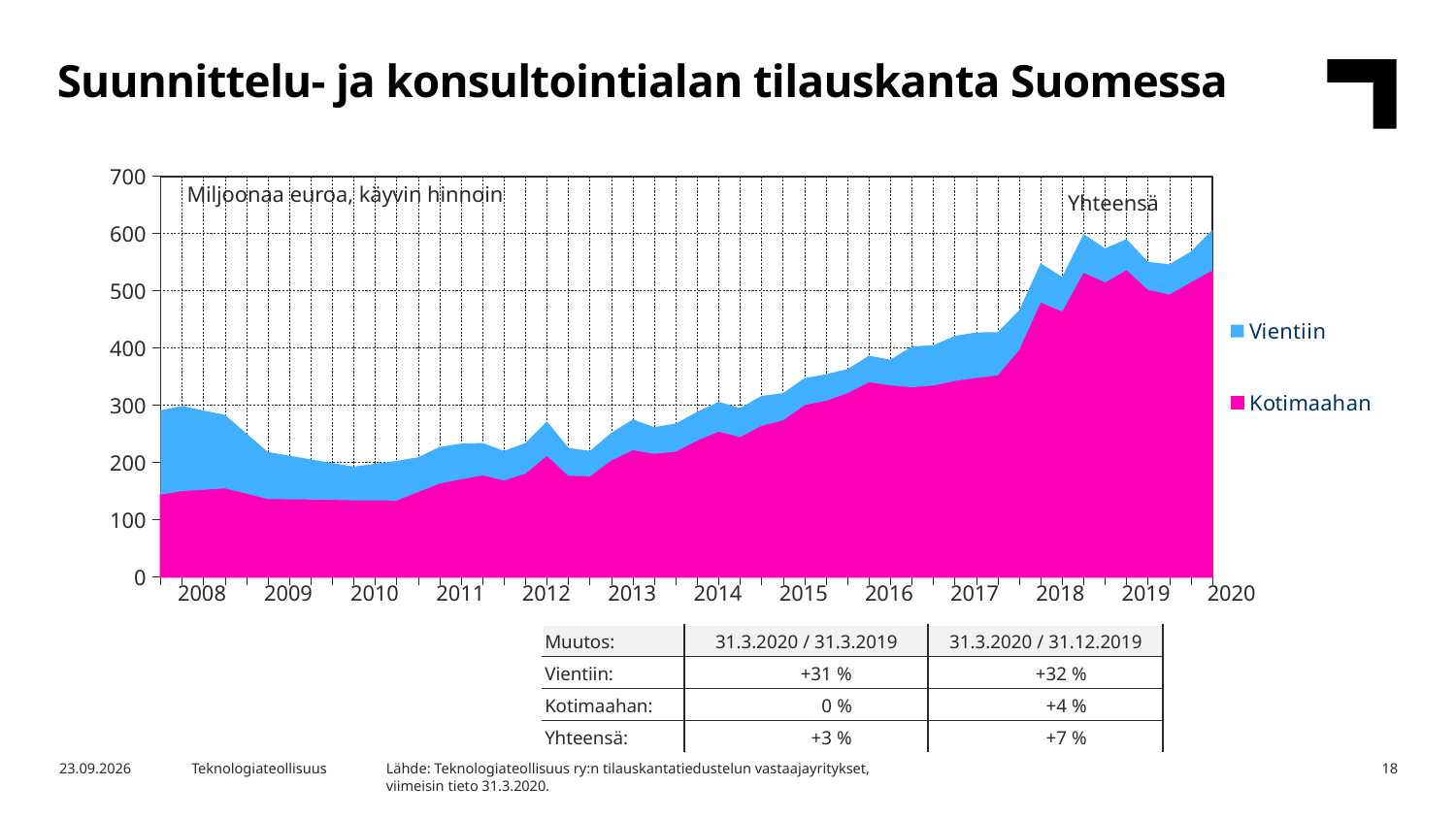
Is the value for Kotimaahan at 2020 greater or less than 500? greater Is the value for Kotimaahan at the start of 2008 greater or less than 200? less What are the two series named in the chart legend? Vientiin and Kotimaahan What unit label is printed inside the chart area at the top left? Miljoonaa euroa, käyvin hinnoin Is the total (Yhteensä) value at 2016 greater or less than 300? greater At 2020, which series has the larger value, Vientiin or Kotimaahan? Kotimaahan How many series does the chart legend list? 2 What kind of chart is shown on the slide? Stacked area chart How many year labels are shown on the x axis? 13 Does the Kotimaahan series generally rise or fall from 2008 to 2020? Rise